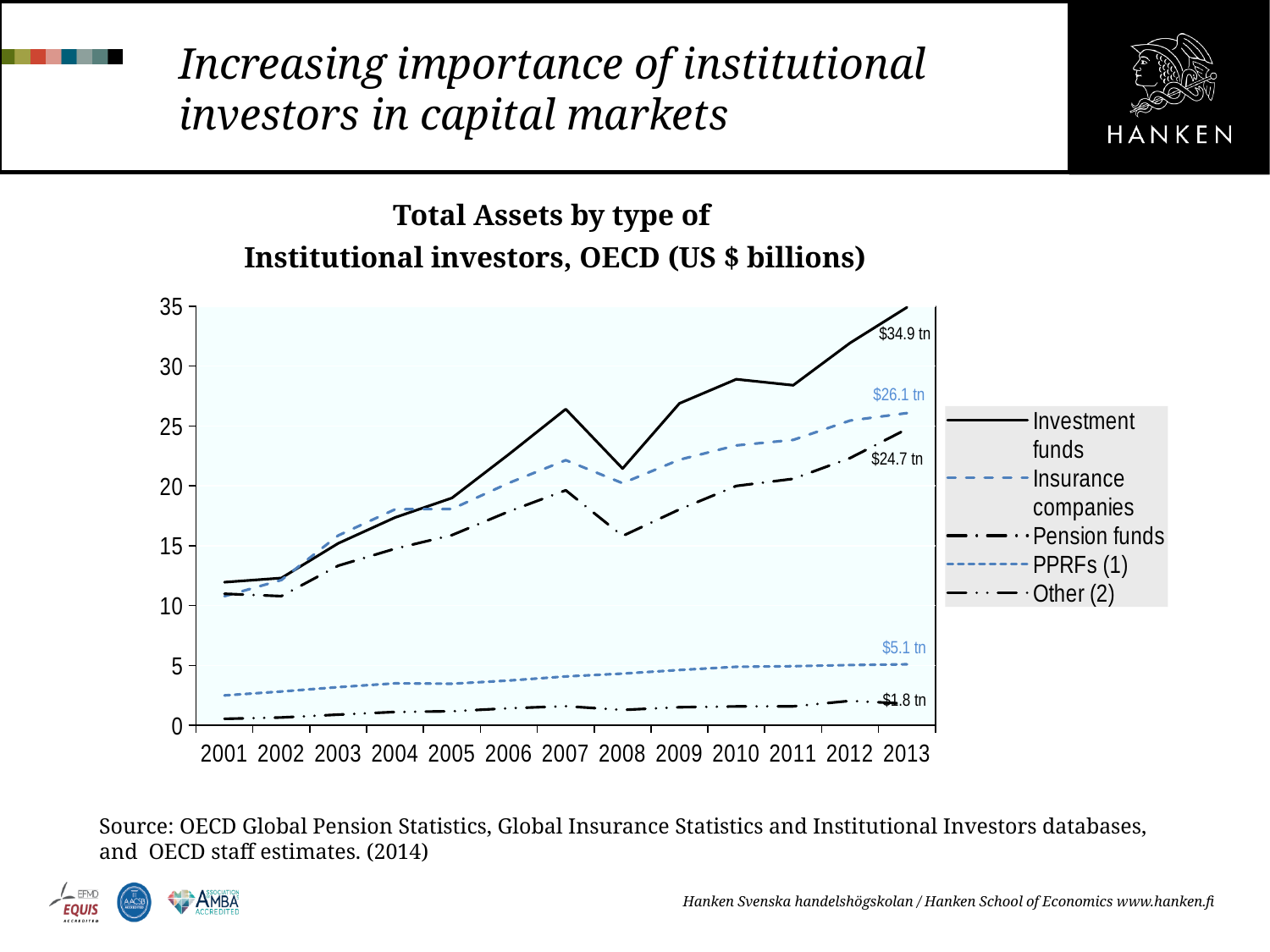
What is the labelled value for Investment funds in 2013? $34.9 tn How many series does the legend list? 5 Is the value for Investment funds in 2007 greater or less than 25? greater What is the difference between the 2013 values for Investment funds and Insurance companies? $8.8 tn Which series has the highest value in 2013? Investment funds Which series has the lowest value in 2013? Other (2) What is the labelled value for Insurance companies in 2013? $26.1 tn What is the labelled value for PPRFs (1) in 2013? $5.1 tn What is the labelled value for Pension funds in 2013? $24.7 tn What is the labelled value for Other (2) in 2013? $1.8 tn How many years are shown along the x axis? 13 What kind of chart is shown on the slide? line chart